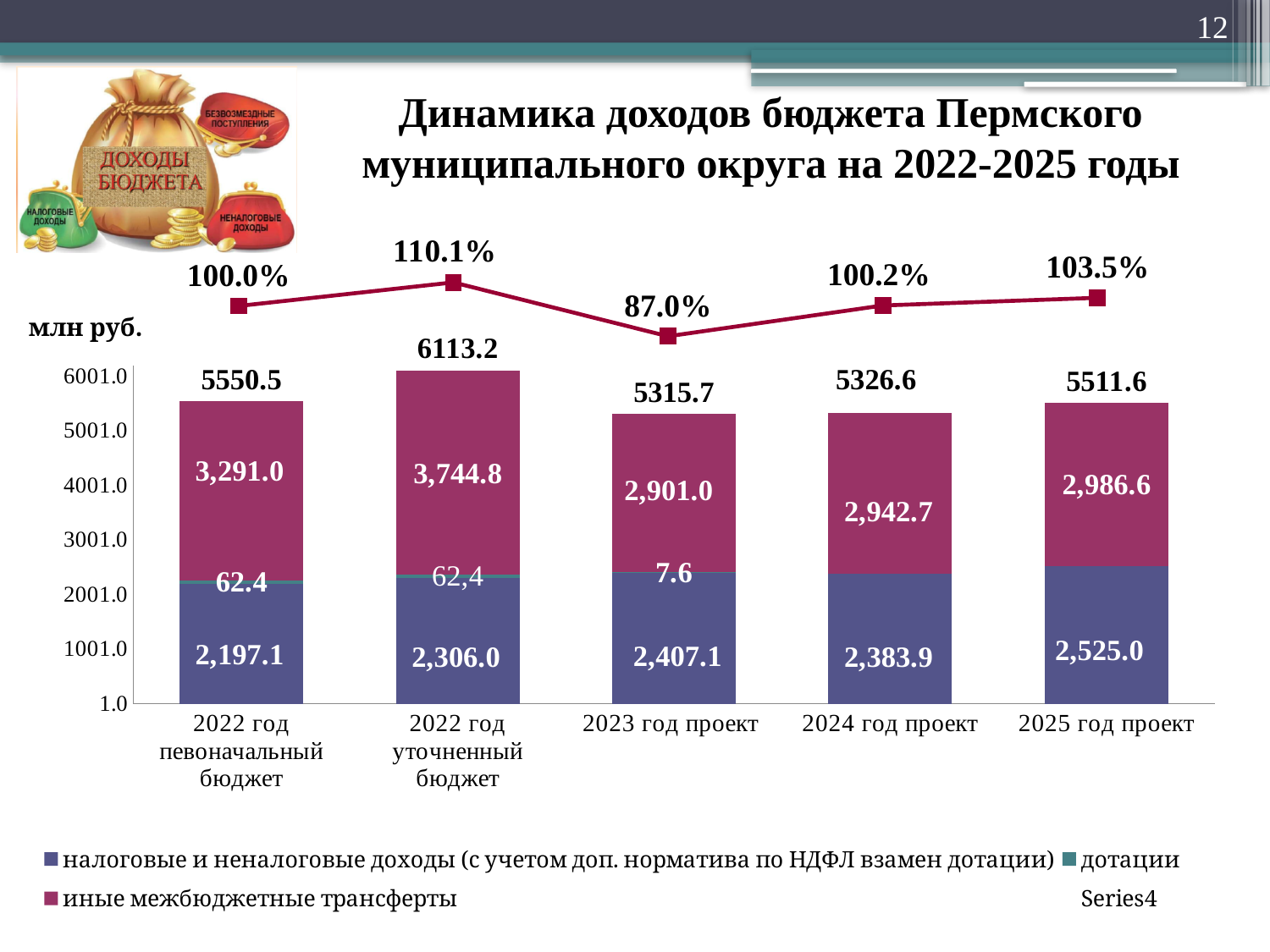
What kind of chart is this? Stacked bar chart with a line What is the value of иные межбюджетные трансферты for 2023 год проект? 2,901.0 Which category has the lowest total bar value? 2023 год проект What unit is indicated for the bar values on the chart? млн руб. What is the difference between the total for 2022 год уточненный бюджет and the total for 2022 год певоначальный бюджет? 562.7 How many series does the legend list? 4 Which is larger: иные межбюджетные трансферты for 2024 год проект or for 2025 год проект? 2025 год проект What percentage is shown on the line for 2023 год проект? 87.0% What is the value of налоговые и неналоговые доходы for 2025 год проект? 2,525.0 What is the total value shown above the bar for 2022 год уточненный бюджет? 6113.2 How many categories are shown on the x axis? 5 Which category has the highest total bar value? 2022 год уточненный бюджет